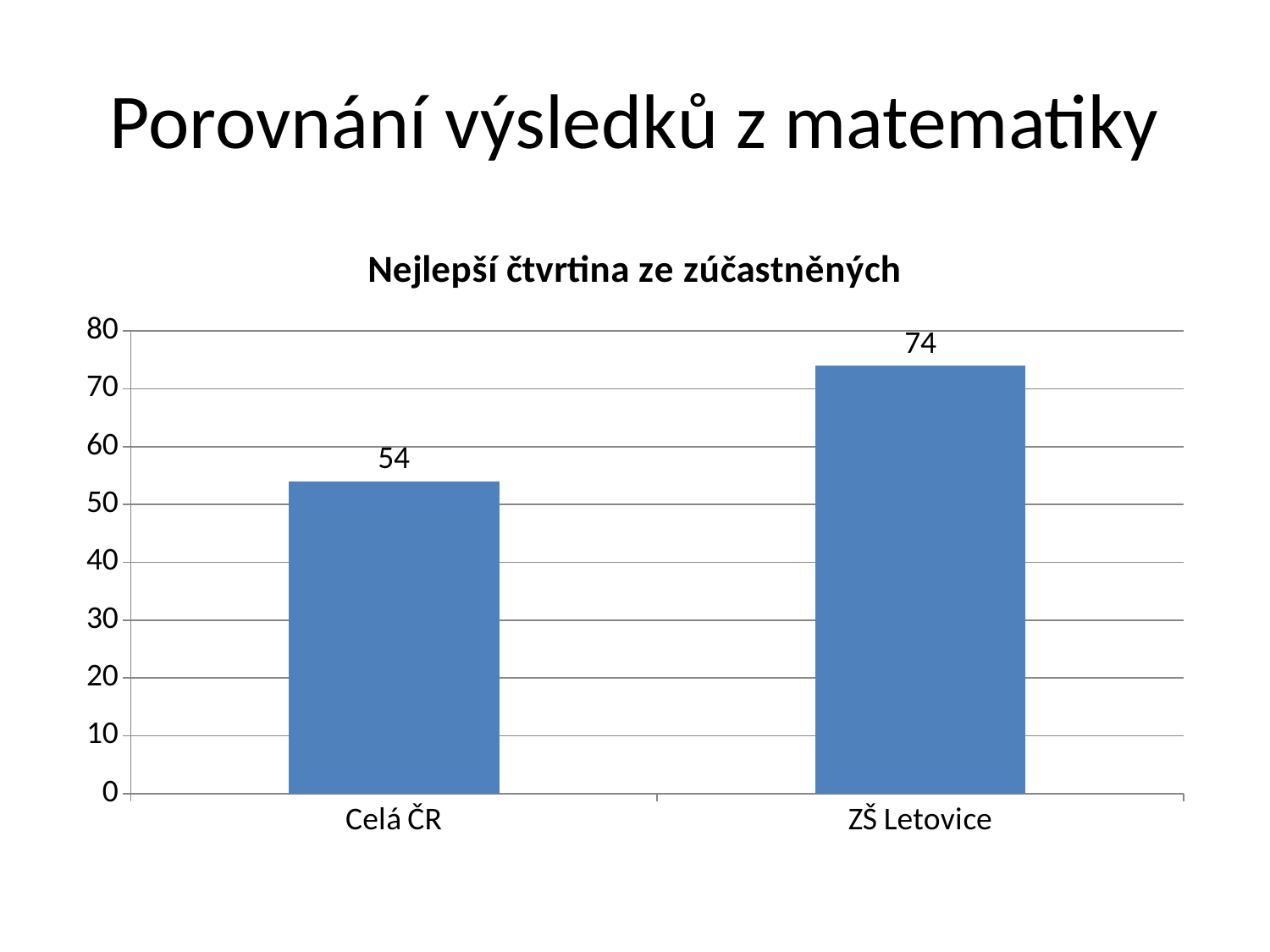
Which category has the lowest value? Celá ČR What is the value for ZŠ Letovice? 74 What is the difference between the values for ZŠ Letovice and Celá ČR? 20 How many categories are shown in the chart? 2 Is the value for ZŠ Letovice greater or less than 70? greater Which is larger, the value for Celá ČR or the value for ZŠ Letovice? ZŠ Letovice What is the highest value shown on the vertical axis? 80 What is the value for Celá ČR? 54 Which category has the highest value? ZŠ Letovice Is the value for Celá ČR greater or less than 60? less What is the title of the chart? Nejlepší čtvrtina ze zúčastněných What kind of chart is shown on the slide? bar chart